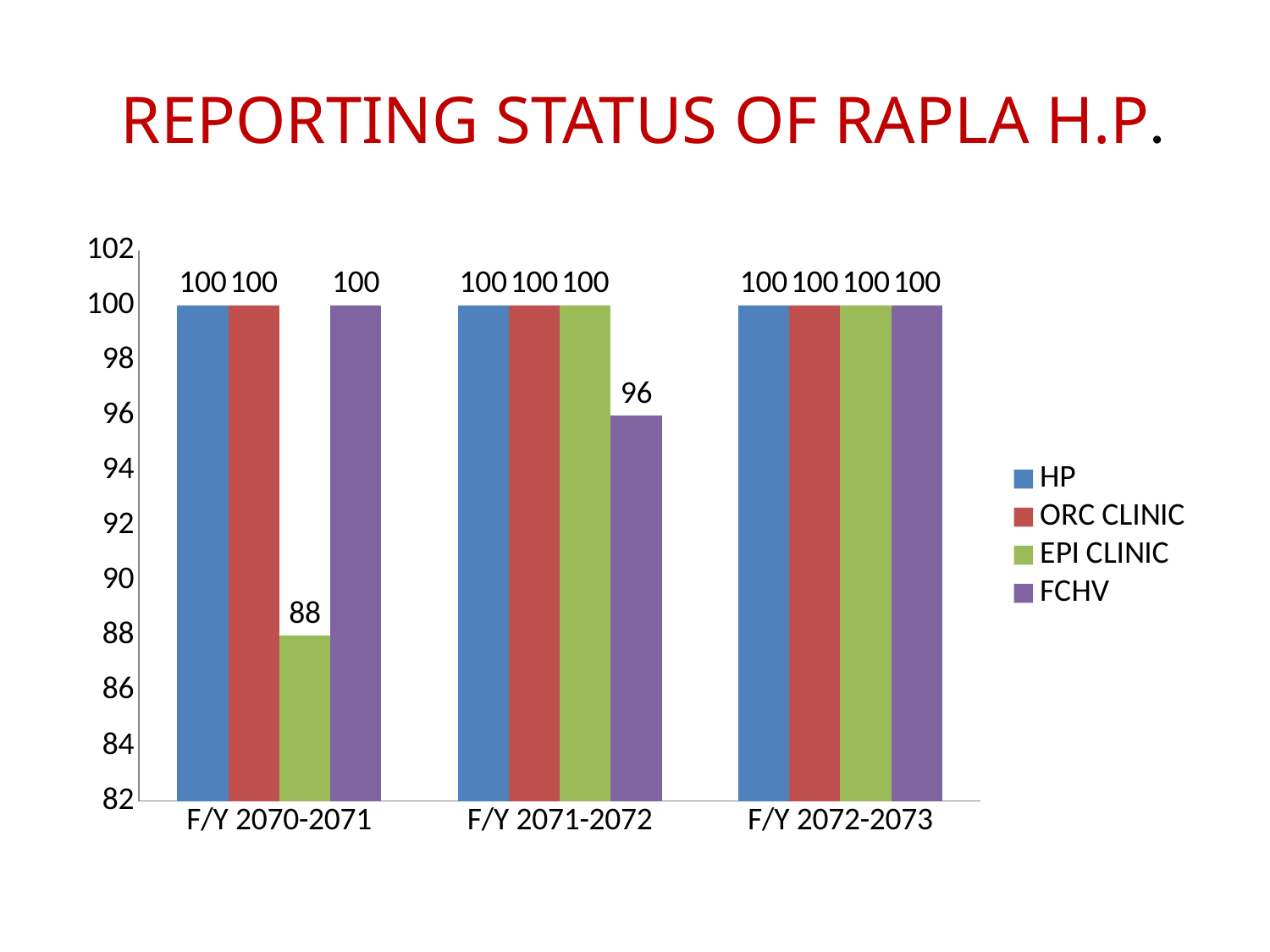
Which is larger, the EPI CLINIC value in F/Y 2070-2071 or the FCHV value in F/Y 2071-2072? FCHV value in F/Y 2071-2072 How many fiscal year categories are shown on the x axis? 3 Which series has the lowest value in F/Y 2070-2071? EPI CLINIC Does the EPI CLINIC value rise or fall from F/Y 2070-2071 to F/Y 2071-2072? Rise What is the difference between the FCHV value and the EPI CLINIC value in F/Y 2070-2071? 12 What is the value for FCHV in F/Y 2071-2072? 96 How many series does the legend list? 4 What is the value for HP in F/Y 2072-2073? 100 What is the difference between the HP value and the FCHV value in F/Y 2071-2072? 4 Which series has the lowest value in F/Y 2071-2072? FCHV What kind of chart is shown on the slide? Bar chart What is the value for EPI CLINIC in F/Y 2070-2071? 88